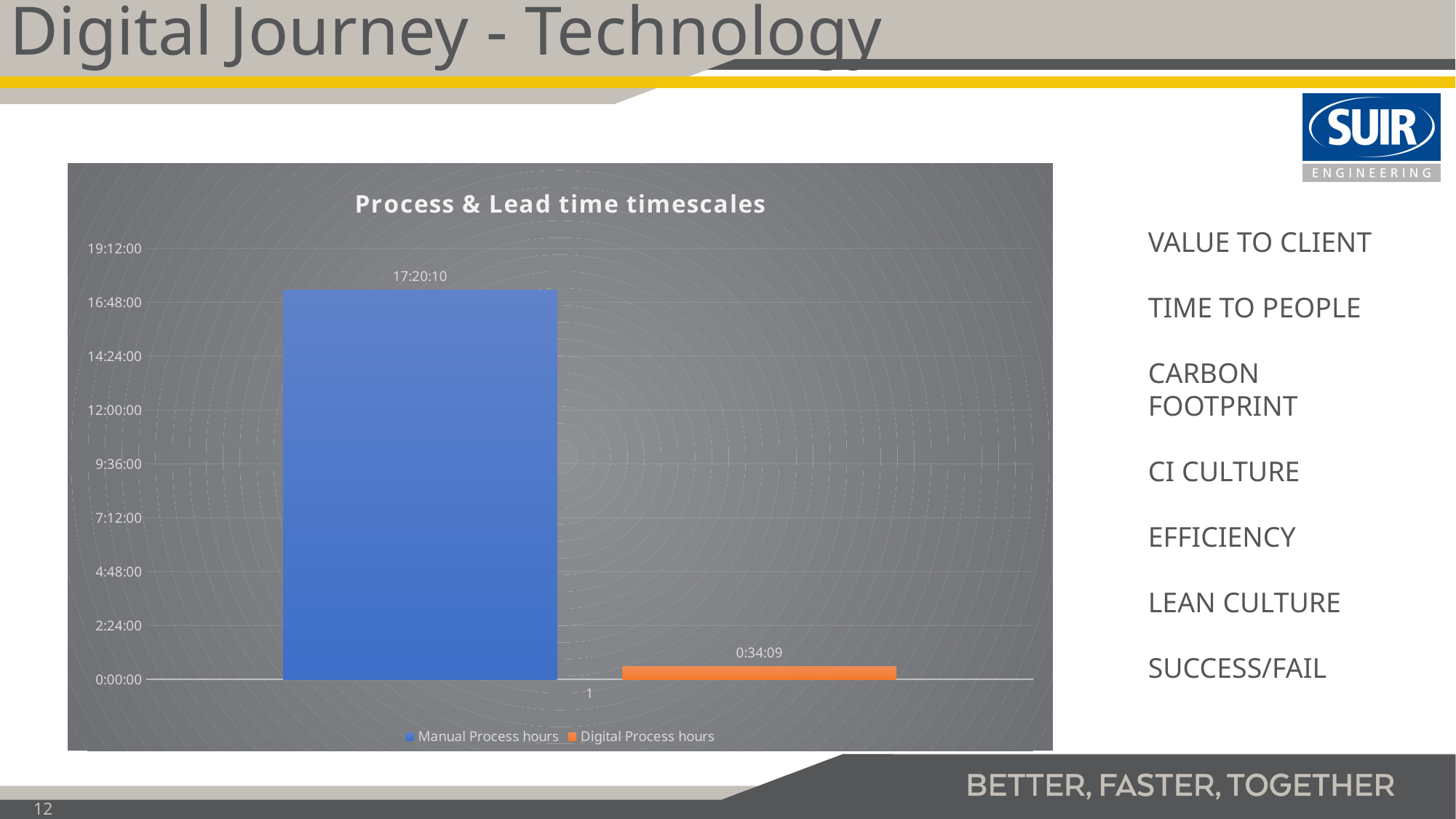
What is the value of the Manual Process hours bar? 17:20:10 What is the difference between the Manual Process hours value and the Digital Process hours value? 16:46:01 Which series has the higher value, Manual Process hours or Digital Process hours? Manual Process hours How many series does the legend list? 2 Which series has the highest value in the chart? Manual Process hours How many categories are shown on the x axis? 1 What kind of chart is shown on the slide? Bar chart Which series has the lowest value in the chart? Digital Process hours Is the value for Digital Process hours greater or less than 2:24:00? less Is the value for Manual Process hours greater or less than 16:48:00? greater What is the title of the chart? Process & Lead time timescales What is the value of the Digital Process hours bar? 0:34:09